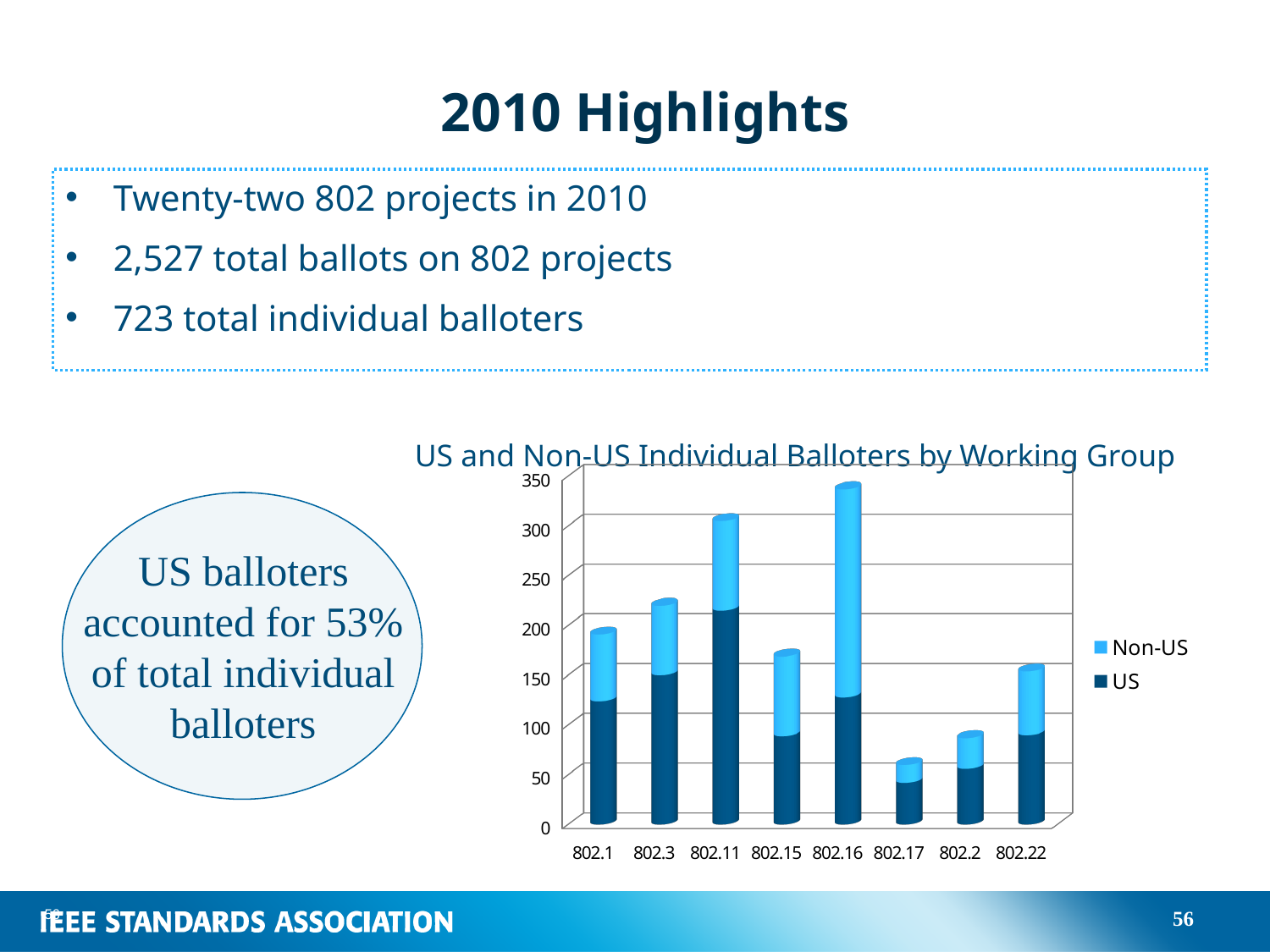
Which has a larger US segment, 802.11 or 802.16? 802.11 Which working group has the tallest stacked bar (most total individual balloters)? 802.16 How many series does the chart's legend list? 2 Which working group has the shortest stacked bar (fewest total individual balloters)? 802.17 Which has a taller total bar, 802.3 or 802.15? 802.3 Is the total bar height for 802.16 greater or less than 300? greater Which series is shown in the darker blue colour in the chart? US How many working groups are shown on the x axis of the chart? 8 What is the title of the chart? US and Non-US Individual Balloters by Working Group What kind of chart is shown on the slide? Stacked bar chart Is the total bar height for 802.17 greater or less than 100? less Which working group has the largest US segment? 802.11